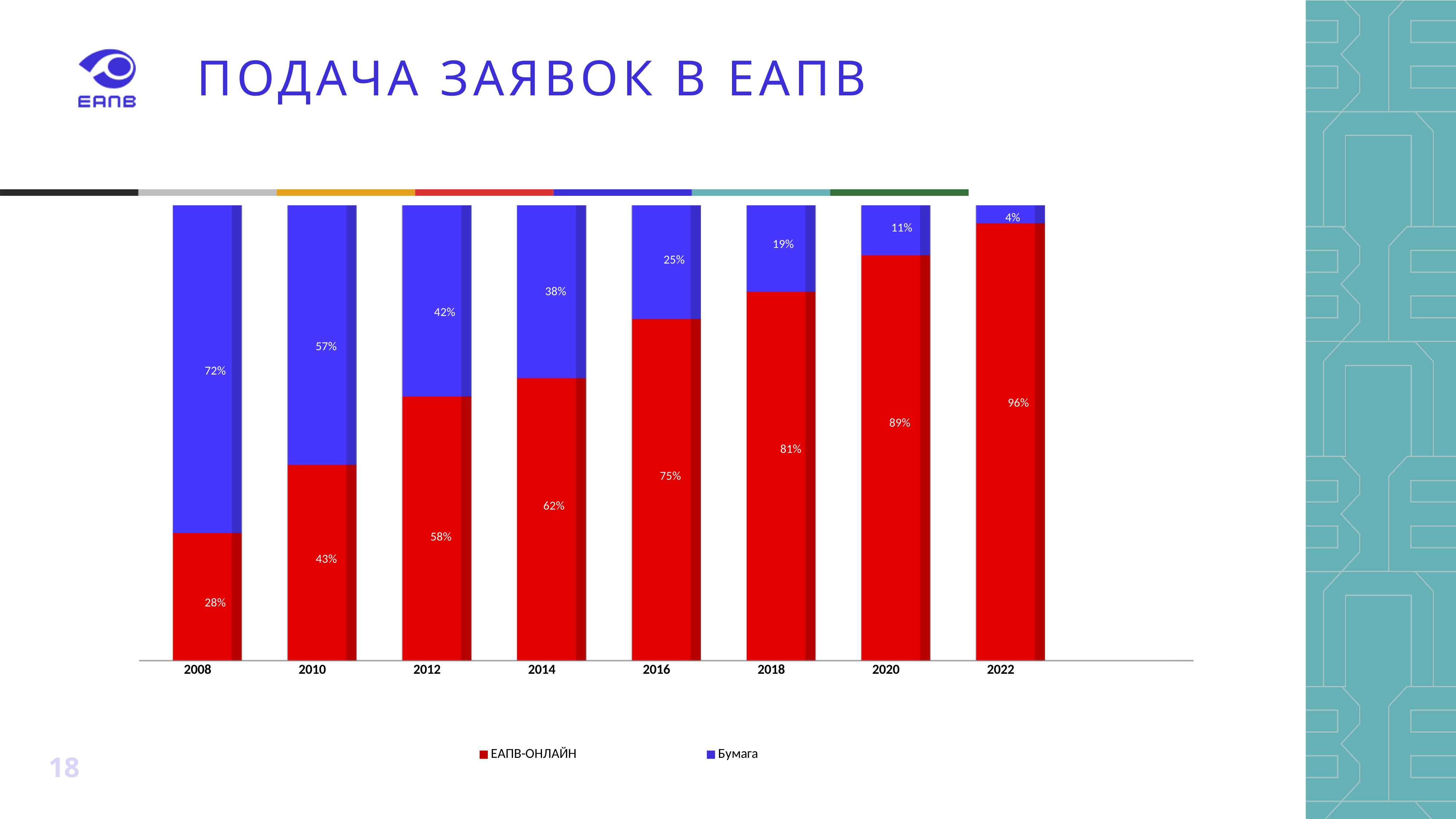
Which is larger in 2012: ЕАПВ-ОНЛАЙН or Бумага? ЕАПВ-ОНЛАЙН What kind of chart is shown on the slide? Stacked bar chart How many years are shown on the x axis? 8 In which year is the ЕАПВ-ОНЛАЙН share highest? 2022 What is the value for ЕАПВ-ОНЛАЙН in 2022? 96% What is the difference between the ЕАПВ-ОНЛАЙН values for 2018 and 2010? 38% What is the value for ЕАПВ-ОНЛАЙН in 2008? 28% Does the ЕАПВ-ОНЛАЙН share rise or fall from 2008 to 2022? Rise What is the value for Бумага in 2020? 11% How many series does the legend list? 2 In which year is the Бумага share lowest? 2022 What is the value for Бумага in 2014? 38%